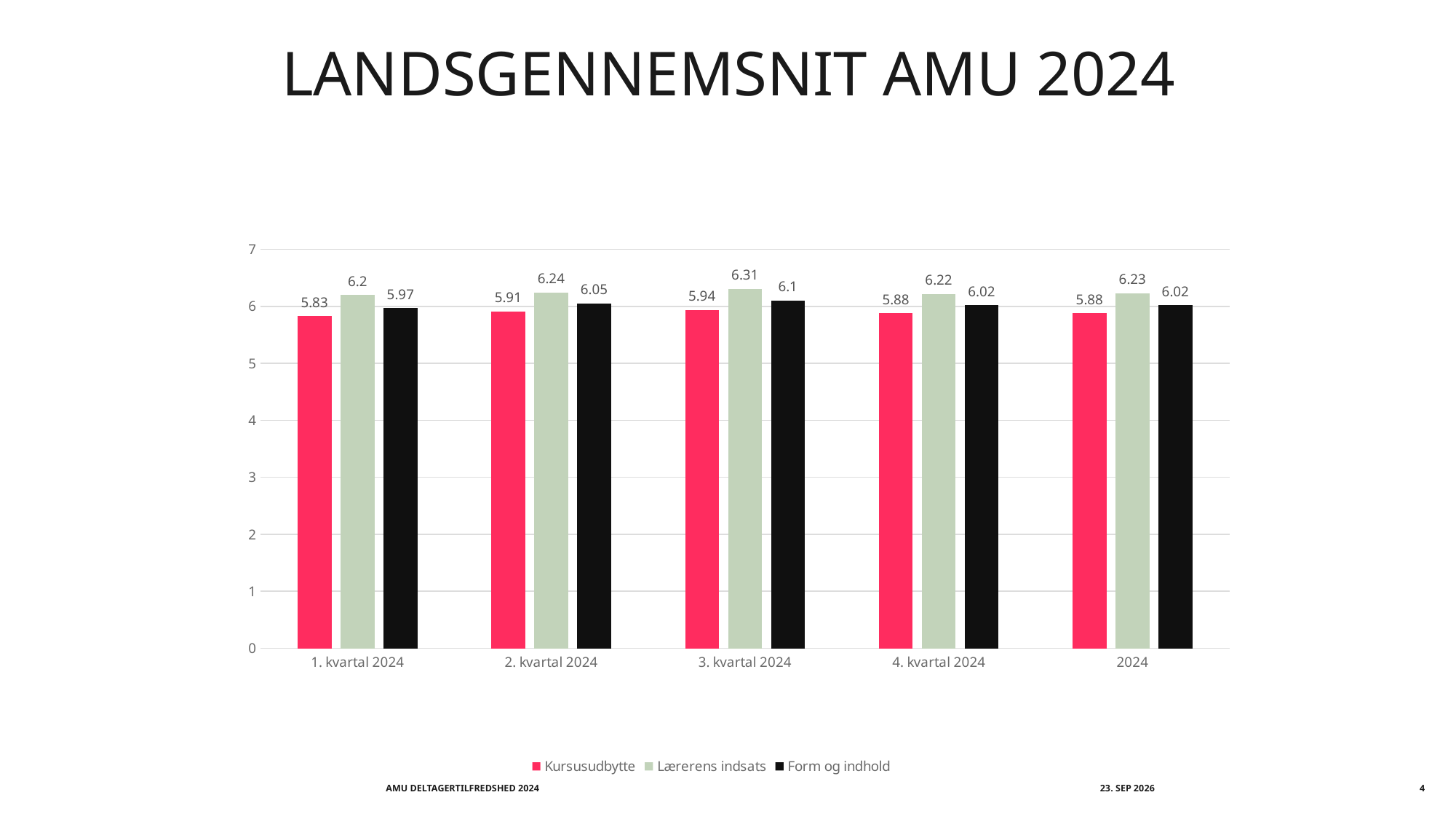
Which is larger in 4. kvartal 2024: Form og indhold or Kursusudbytte? Form og indhold In which category is the Lærerens indsats value highest? 3. kvartal 2024 In which category is the Kursusudbytte value lowest? 1. kvartal 2024 Is the value for Form og indhold in 1. kvartal 2024 greater or less than 6? less What is the difference between Lærerens indsats and Kursusudbytte in 2. kvartal 2024? 0.33 What is the title of the slide? LANDSGENNEMSNIT AMU 2024 How many series does the legend list? 3 What kind of chart is shown on the slide? bar chart What is the value for Kursusudbytte in 1. kvartal 2024? 5.83 How many categories are shown on the x axis? 5 What is the value for Lærerens indsats in 3. kvartal 2024? 6.31 What is the value for Form og indhold in 2024? 6.02